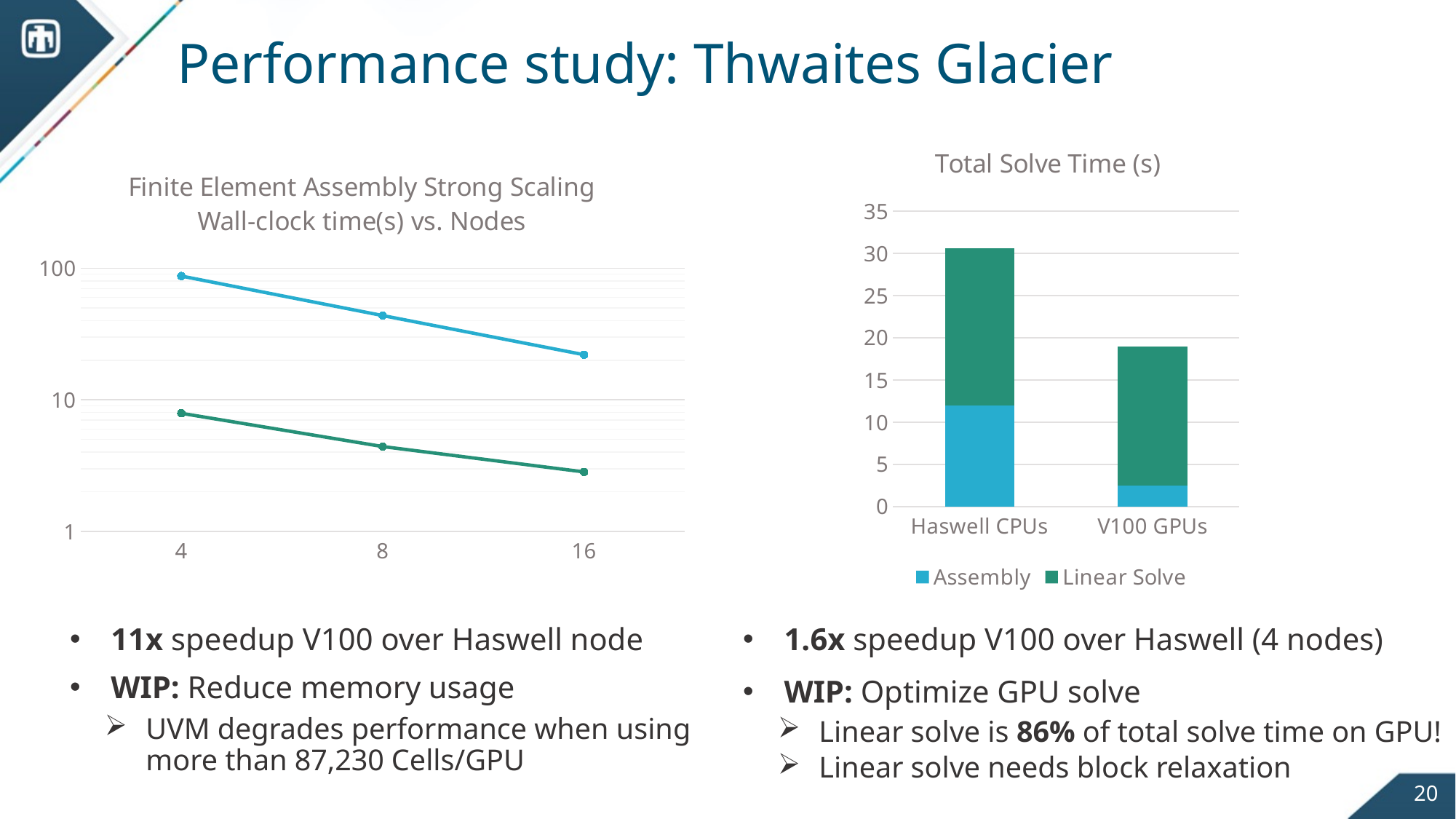
What kind of chart is the 'Finite Element Assembly Strong Scaling' chart on the left? Line chart What kind of chart is the 'Total Solve Time (s)' chart? Stacked bar chart In the 'Total Solve Time (s)' chart, which category has the taller stacked bar? Haswell CPUs In the 'Finite Element Assembly Strong Scaling' chart, is the value of the green line at 4 nodes greater or less than 10? less In the 'Total Solve Time (s)' chart, what are the two series named in the legend? Assembly and Linear Solve In the 'Total Solve Time (s)' chart, is the Assembly segment for V100 GPUs greater or less than 5? less In the 'Total Solve Time (s)' chart, is the Assembly segment for Haswell CPUs greater or less than 10? greater In the 'Finite Element Assembly Strong Scaling' chart, how many node counts are shown on the x axis? 3 In the 'Total Solve Time (s)' chart, how many series does the legend list? 2 In the 'Finite Element Assembly Strong Scaling' chart, do the wall-clock times rise or fall as the number of nodes increases? Fall